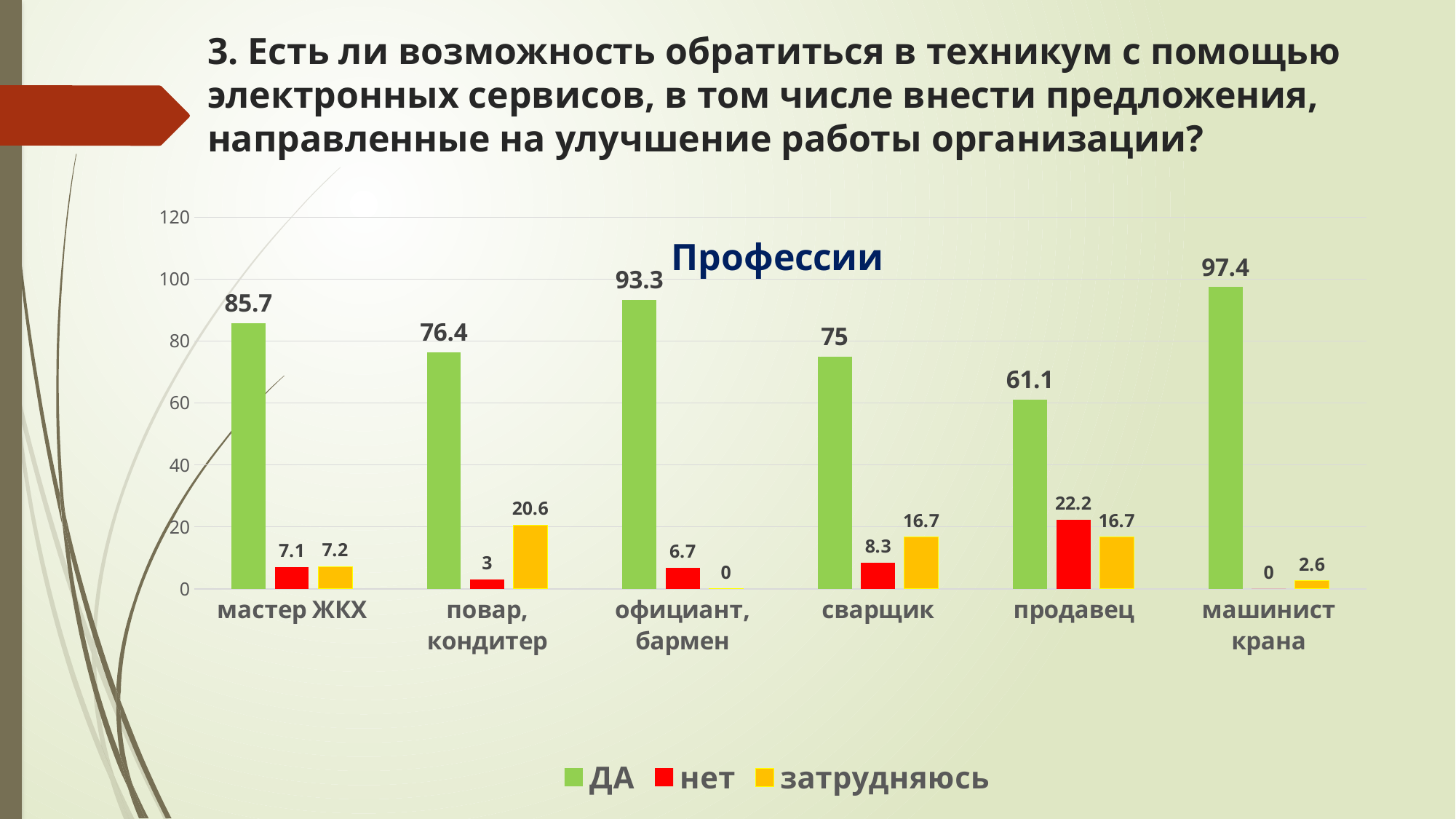
Is the ДА value for повар, кондитер greater or less than 80? less How many categories are shown on the x axis? 6 Which category has the highest value in the ДА series? машинист крана Which category has the lowest value in the ДА series? продавец What is the value of the нет series for продавец? 22.2 How many series does the legend list? 3 What is the difference between the ДА values for официант, бармен and сварщик? 18.3 What kind of chart is shown on the slide? bar chart Which is larger: the затрудняюсь value for мастер ЖКХ or for сварщик? сварщик What is the title of the chart? Профессии What is the value of the ДА series for машинист крана? 97.4 What is the value of the затрудняюсь series for повар, кондитер? 20.6